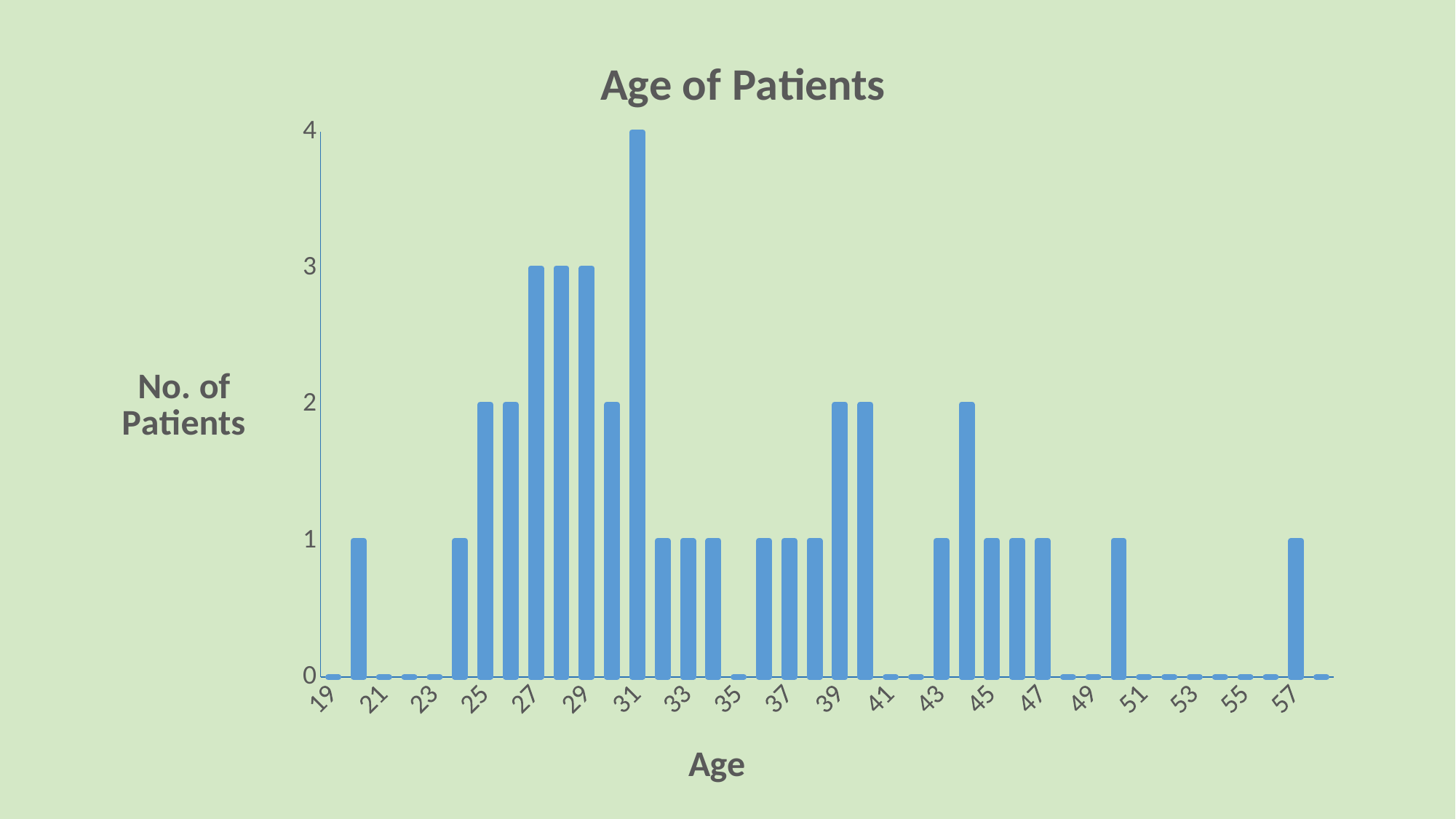
What type of chart is shown on the slide? bar chart How many patients are aged 39? 2 What is the title of the chart? Age of Patients What is the highest value shown on the vertical axis? 4 What is the label of the vertical axis? No. of Patients Which has more patients, age 29 or age 45? 29 What is the difference between the number of patients aged 31 and the number aged 27? 1 How many patients are aged 35? 0 How many patients are aged 27? 3 Which age has the highest number of patients? 31 How many patients are aged 57? 1 How many patients are aged 31? 4